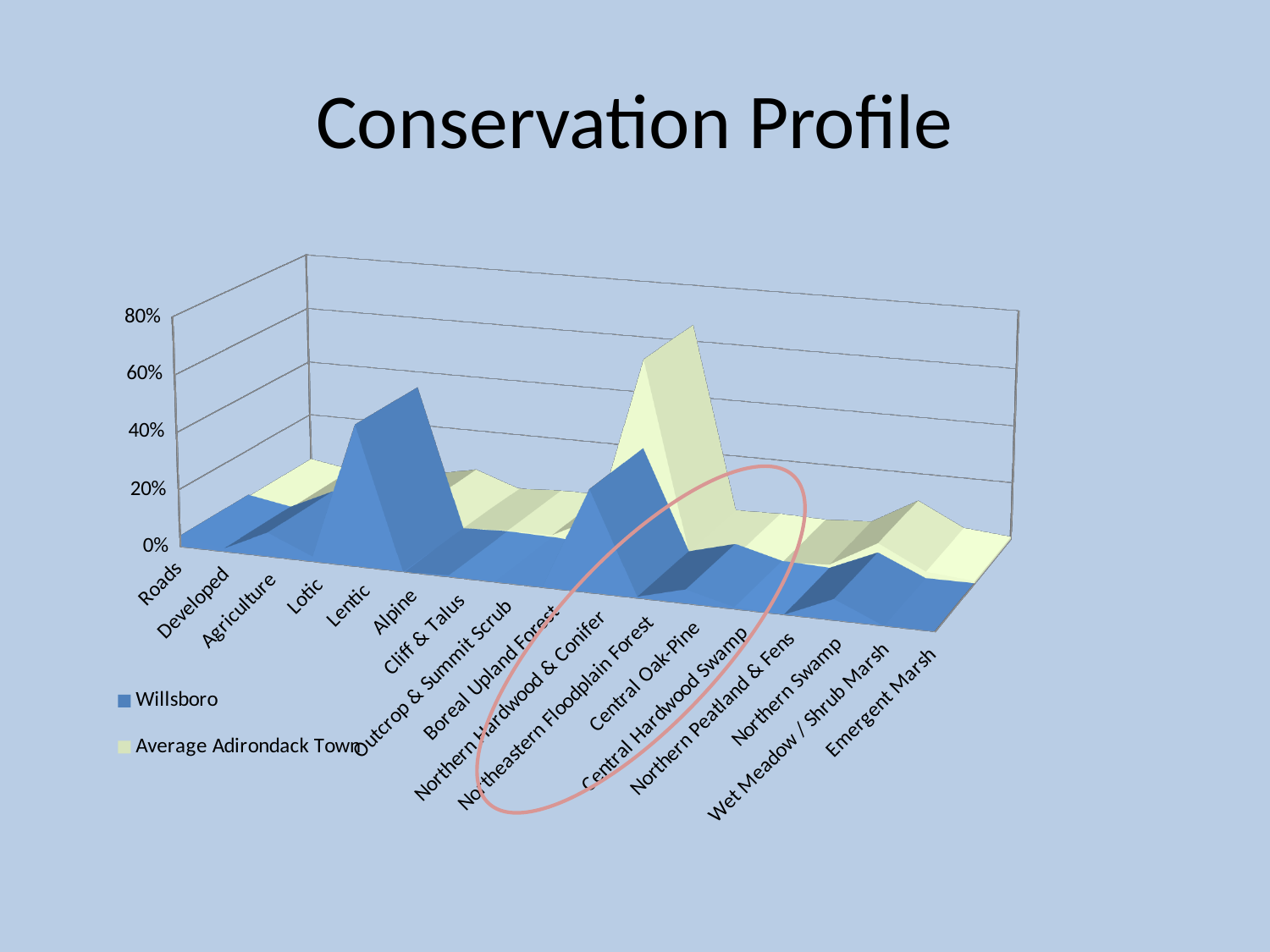
Which category has the highest value for the Average Adirondack Town series? Northern Hardwood & Conifer For Northern Hardwood & Conifer, which series has the larger value, Willsboro or Average Adirondack Town? Average Adirondack Town How many series does the legend list? 2 Is the Average Adirondack Town value for Northern Hardwood & Conifer greater or less than 40%? greater What are the two series named in the legend? Willsboro and Average Adirondack Town Is the Willsboro value for Roads greater or less than 40%? less For Lentic, which series has the larger value, Willsboro or Average Adirondack Town? Willsboro Which category has the highest value for the Willsboro series? Lentic What is the title of the chart? Conservation Profile How many categories are shown along the x axis? 17 What kind of chart is shown on the slide? Area chart Is the Willsboro value for Lentic greater or less than 20%? greater